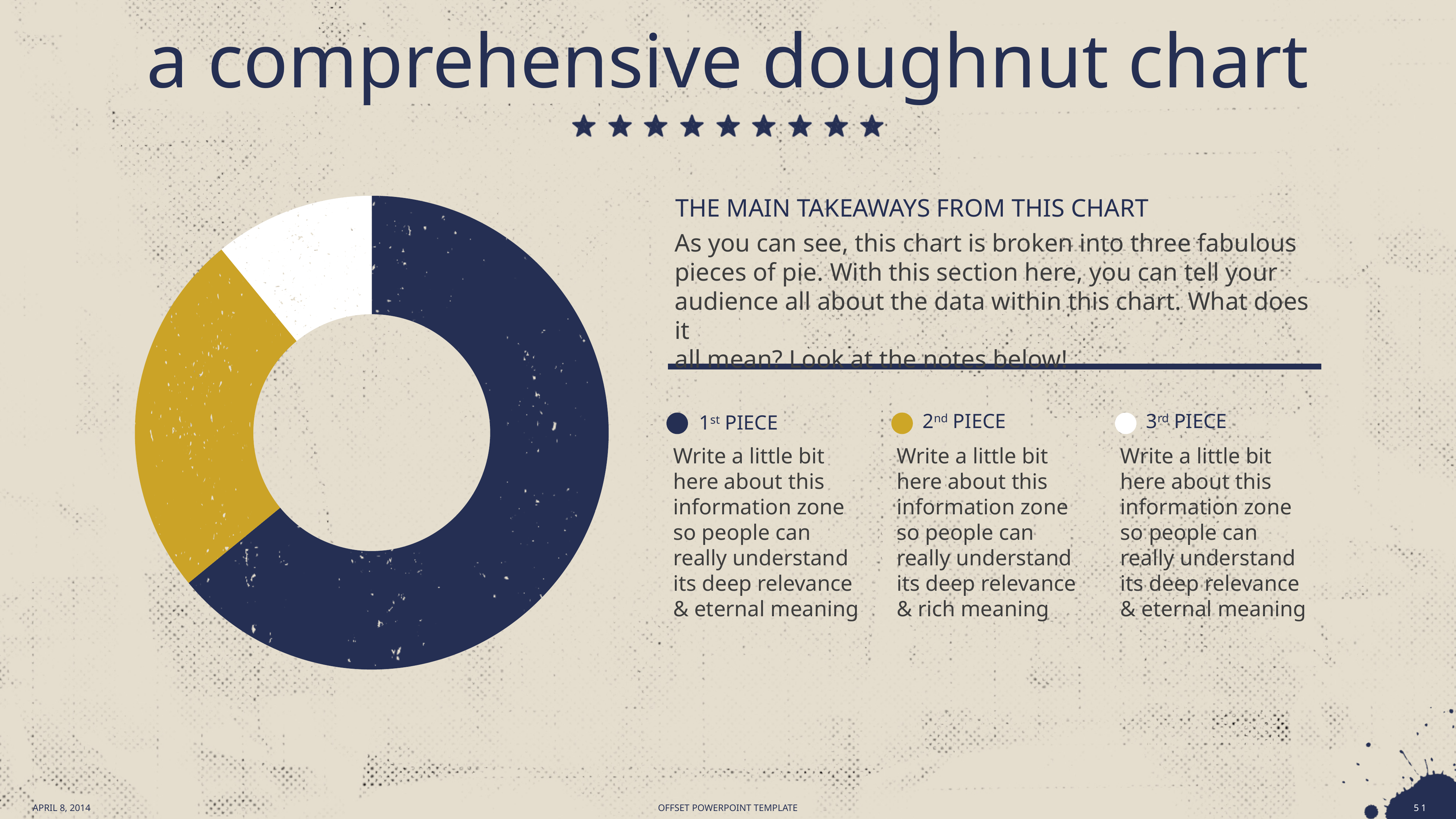
What kind of chart is shown on the slide? doughnut chart Which piece of the doughnut chart is the largest? 1st PIECE Which piece of the doughnut chart is the smallest? 3rd PIECE How many pieces does the doughnut chart have? 3 What colour represents the 2nd PIECE in the doughnut chart? gold Does the 1st PIECE take up more or less than half of the doughnut chart? more Which is larger in the doughnut chart, the 1st PIECE or the 2nd PIECE? 1st PIECE What is the title of the slide containing the doughnut chart? a comprehensive doughnut chart Which is larger in the doughnut chart, the 2nd PIECE or the 3rd PIECE? 2nd PIECE